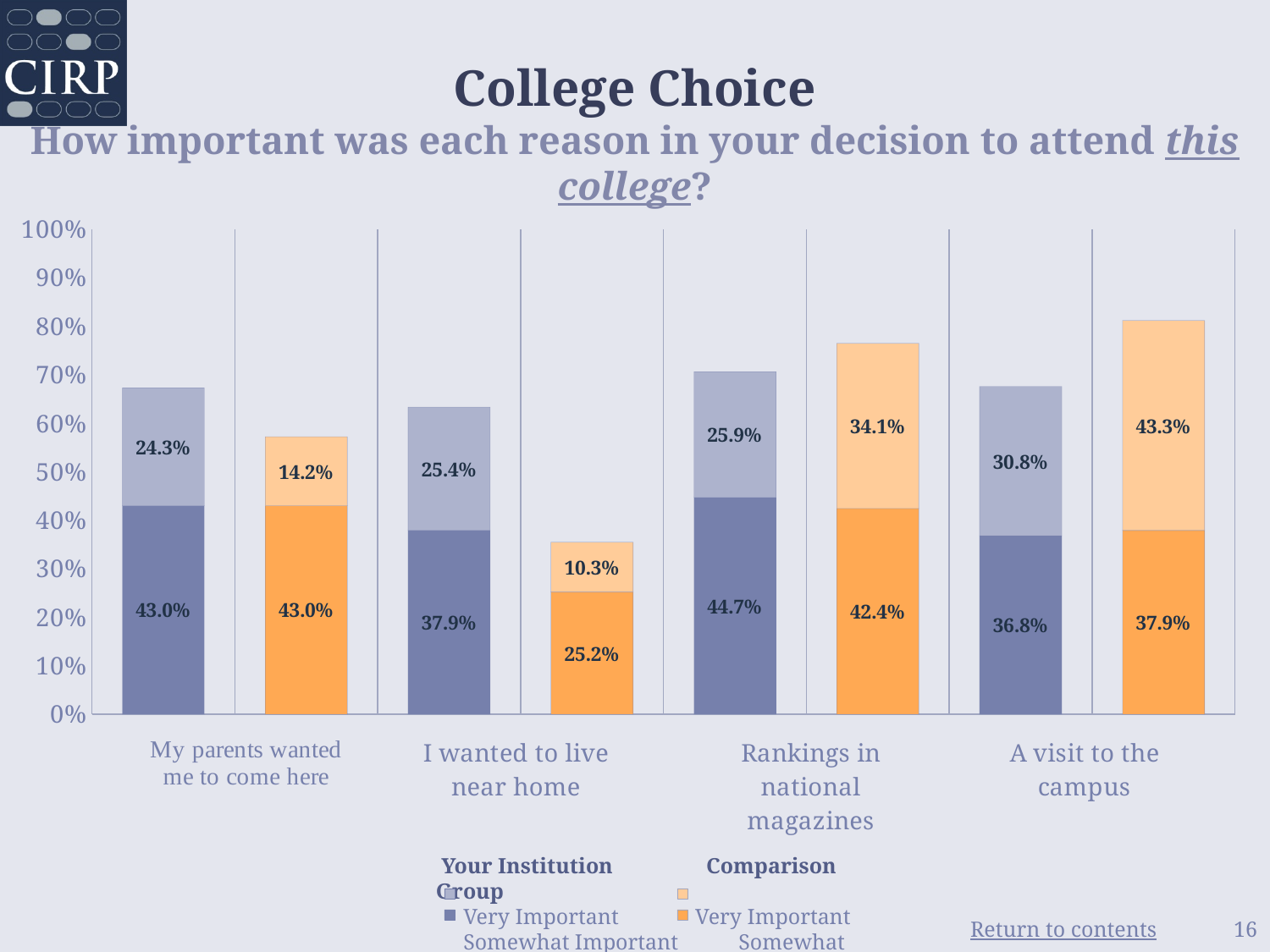
What is the combined total of the Your Institution bar for "My parents wanted me to come here"? 67.3% How many series does the legend list? 4 What is the Very Important percentage for the Comparison Group for "I wanted to live near home"? 25.2% Which reason has the lowest Somewhat Important percentage for the Comparison Group? I wanted to live near home For "A visit to the campus", which group has the larger Somewhat Important percentage, Your Institution or the Comparison Group? Comparison Group How many reasons (categories) are shown on the x axis? 4 What is the difference between the Your Institution and Comparison Group Somewhat Important percentages for "My parents wanted me to come here"? 10.1% What is the combined Very Important and Somewhat Important total for the Comparison Group bar for "I wanted to live near home"? 35.5% Which reason has the highest Very Important percentage for Your Institution? Rankings in national magazines What percentage of the Comparison Group rated "A visit to the campus" as Somewhat Important? 43.3% What type of chart is shown on the slide? Stacked bar chart What percentage of Your Institution students rated "Rankings in national magazines" as Very Important? 44.7%